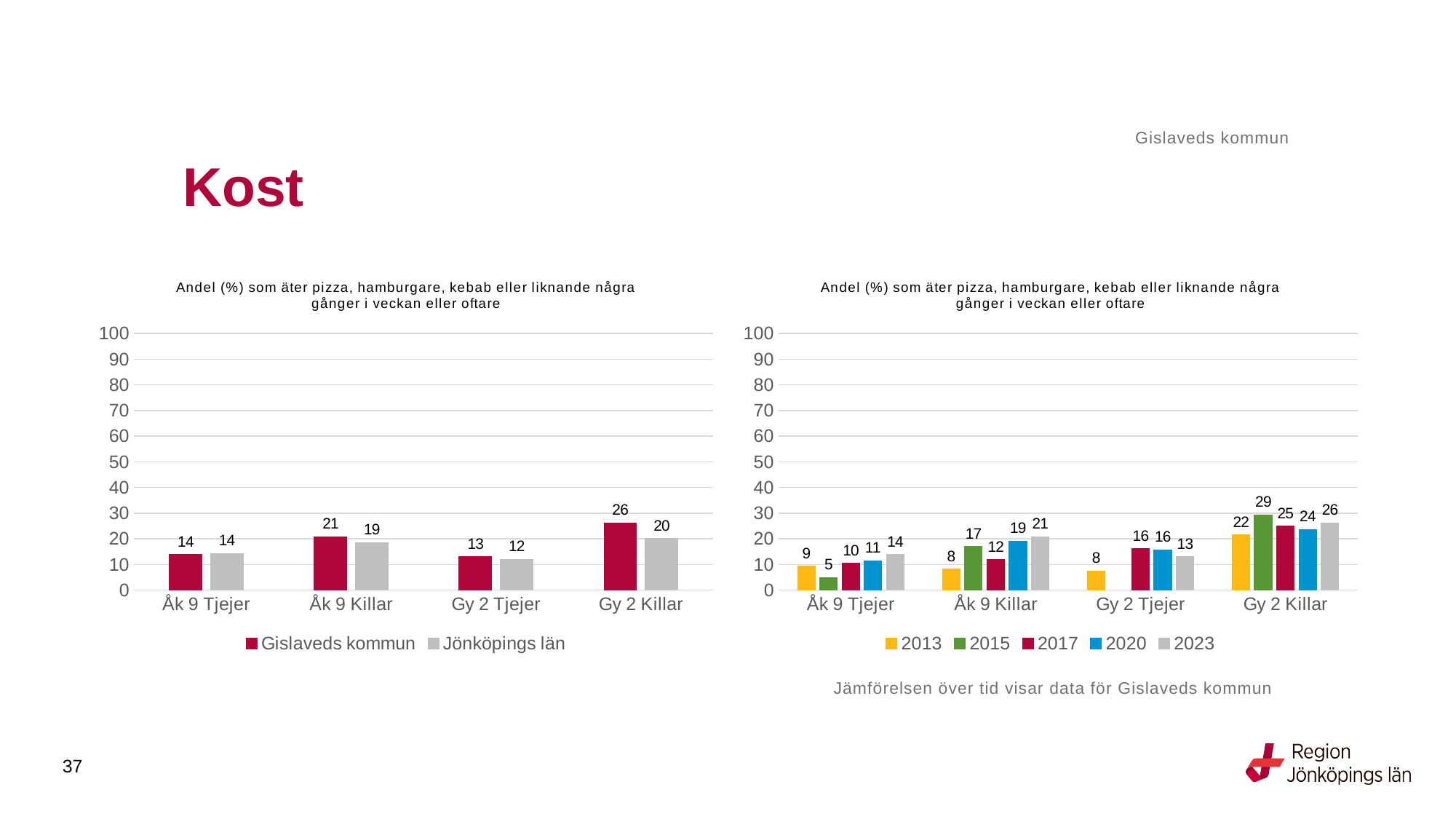
In the left chart, how many series does the legend list? 2 In the left chart, what is the difference between Gislaveds kommun and Jönköpings län for Gy 2 Killar? 6 In the left chart, what is the value for Jönköpings län for Åk 9 Killar? 19 In the right chart, what is the value for 2015 for Gy 2 Killar? 29 What kind of chart is the right chart? Bar chart In the left chart, what is the value for Gislaveds kommun for Gy 2 Killar? 26 In the left chart, which category has the highest value for Gislaveds kommun? Gy 2 Killar In the right chart, which year has the lowest value for Åk 9 Tjejer? 2015 In the right chart, how many series does the legend list? 5 In the right chart, is the value for 2023 larger for Åk 9 Killar or for Gy 2 Tjejer? Åk 9 Killar In the left chart, which category has the lowest value for Jönköpings län? Gy 2 Tjejer In the right chart, what is the value for 2013 for Åk 9 Tjejer? 9